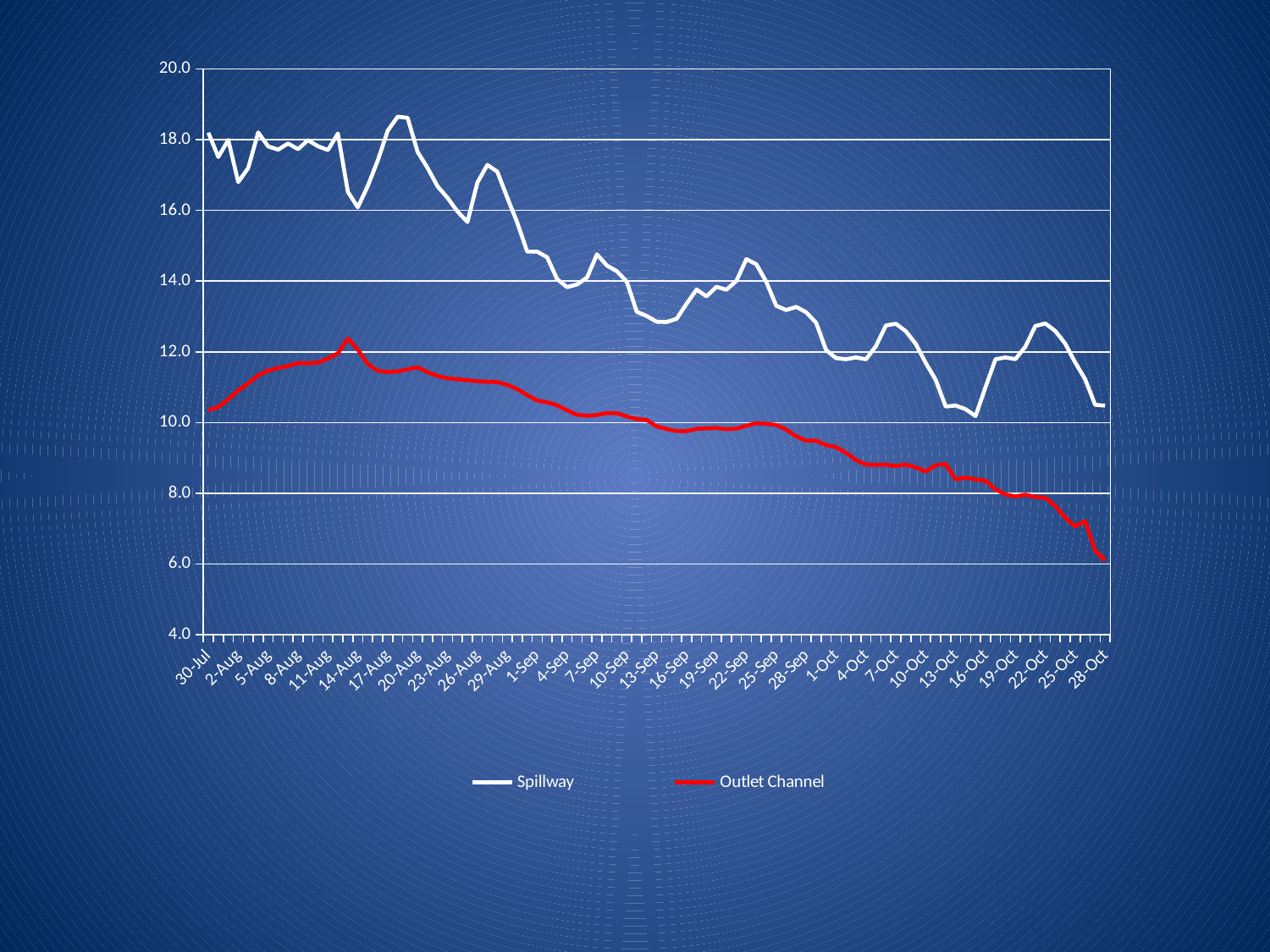
Is the Outlet Channel value at 28-Oct greater or less than 8.0? less What are the names of the two series in the legend? Spillway and Outlet Channel What kind of chart is shown on the slide? line chart Which colour is used for the Outlet Channel line? red Is the Spillway value at 13-Sep greater or less than 14.0? less Is the Spillway value at 28-Oct greater or less than 12.0? less How many series does the legend list? 2 Which series has the higher values throughout the period, Spillway or Outlet Channel? Spillway Does the Outlet Channel line generally rise or fall from 30-Jul to 28-Oct? fall Does the Spillway line generally rise or fall from 30-Jul to 28-Oct? fall